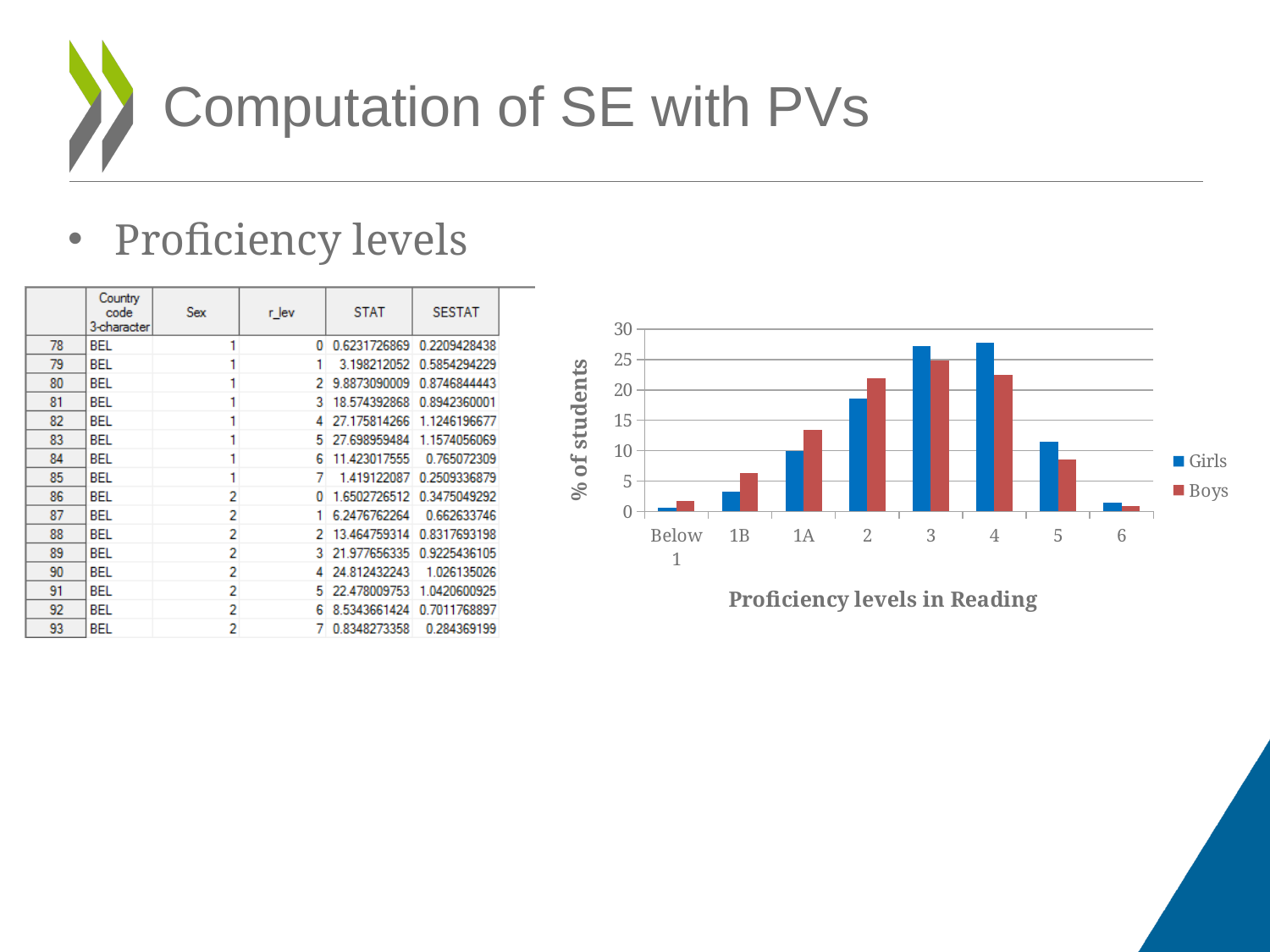
How many proficiency level categories are shown on the x axis of the chart? 8 Is the value for Girls at level 3 greater or less than 25? greater Which proficiency level has the lowest value for Girls? Below 1 What kind of chart is shown on the right of the slide? bar chart Is the value for Boys at level 5 greater or less than 10? less At level 4, which series has the larger value, Girls or Boys? Girls What is the title of the chart's x axis? Proficiency levels in Reading Which proficiency level has the highest value for Boys? 3 At level 1B, which series has the larger value, Girls or Boys? Boys Is the value for Boys at level 2 greater or less than 20? greater How many series does the chart legend list? 2 Which proficiency level has the lowest value for Boys? 6